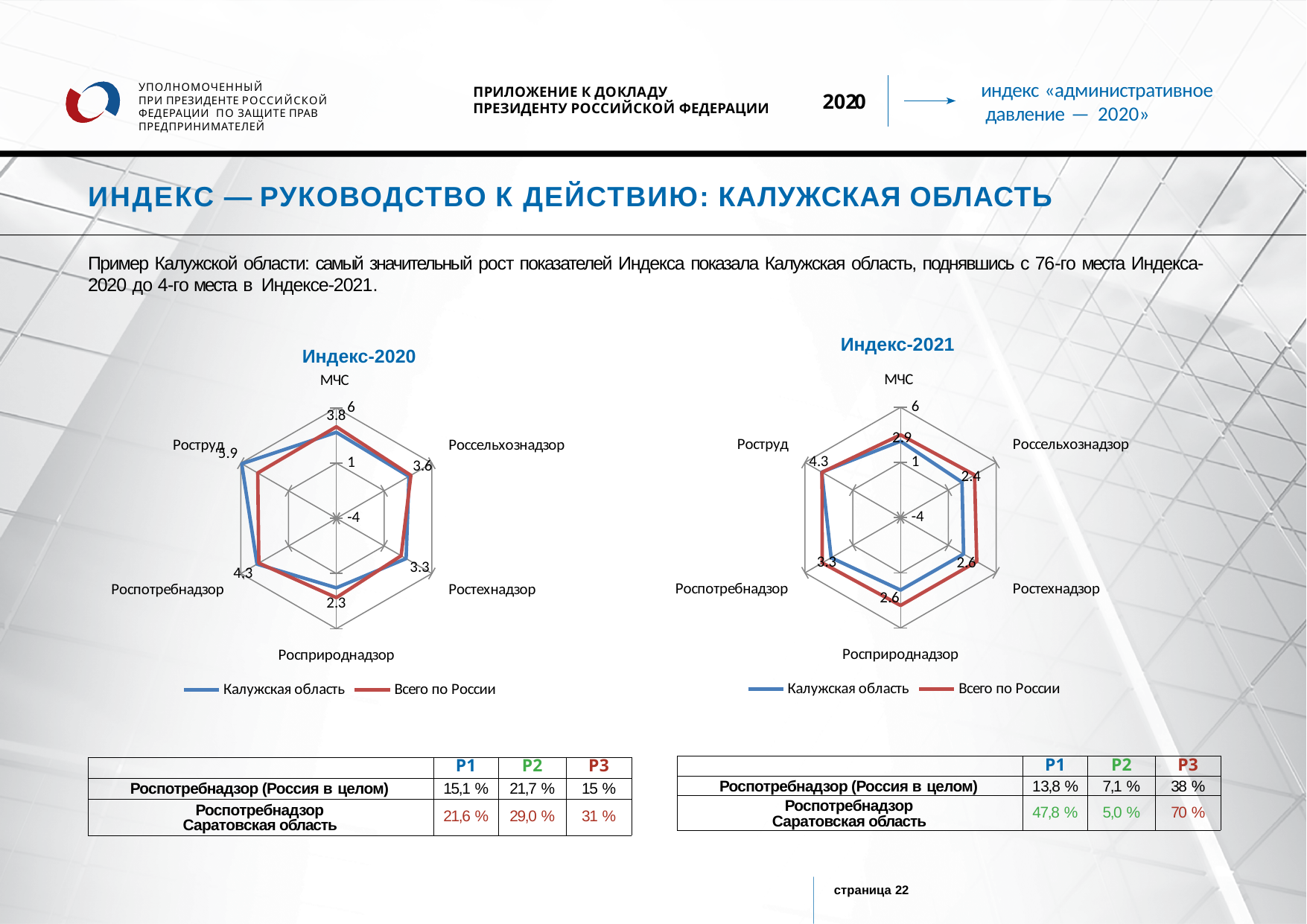
How many axes (categories) does the Индекс-2020 radar chart have? 6 In the Индекс-2020 chart, which is larger for Калужская область: the value on the Роструд axis or on the Роспотребнадзор axis? Роструд In the Индекс-2021 chart, what colour is the line for Калужская область? Blue In the Индекс-2021 chart, which series has the larger value on the Росприроднадзор axis? Всего по России By how much did the Калужская область value on the Роструд axis fall from the Индекс-2020 chart to the Индекс-2021 chart? 1.6 In the Индекс-2021 chart, what is the value for Калужская область on the Роструд axis? 4.3 In the Индекс-2020 chart, on which axis does Калужская область have its highest value? Роструд How many series does the legend of the Индекс-2021 chart list? 2 In the Индекс-2020 chart, on which axis does Калужская область have its lowest value? Росприроднадзор In the Индекс-2021 chart, what is the value for Калужская область on the МЧС axis? 2.9 What kind of chart is the Индекс-2020 chart? Radar chart In the Индекс-2020 chart, what is the value for Калужская область on the Роструд axis? 5.9